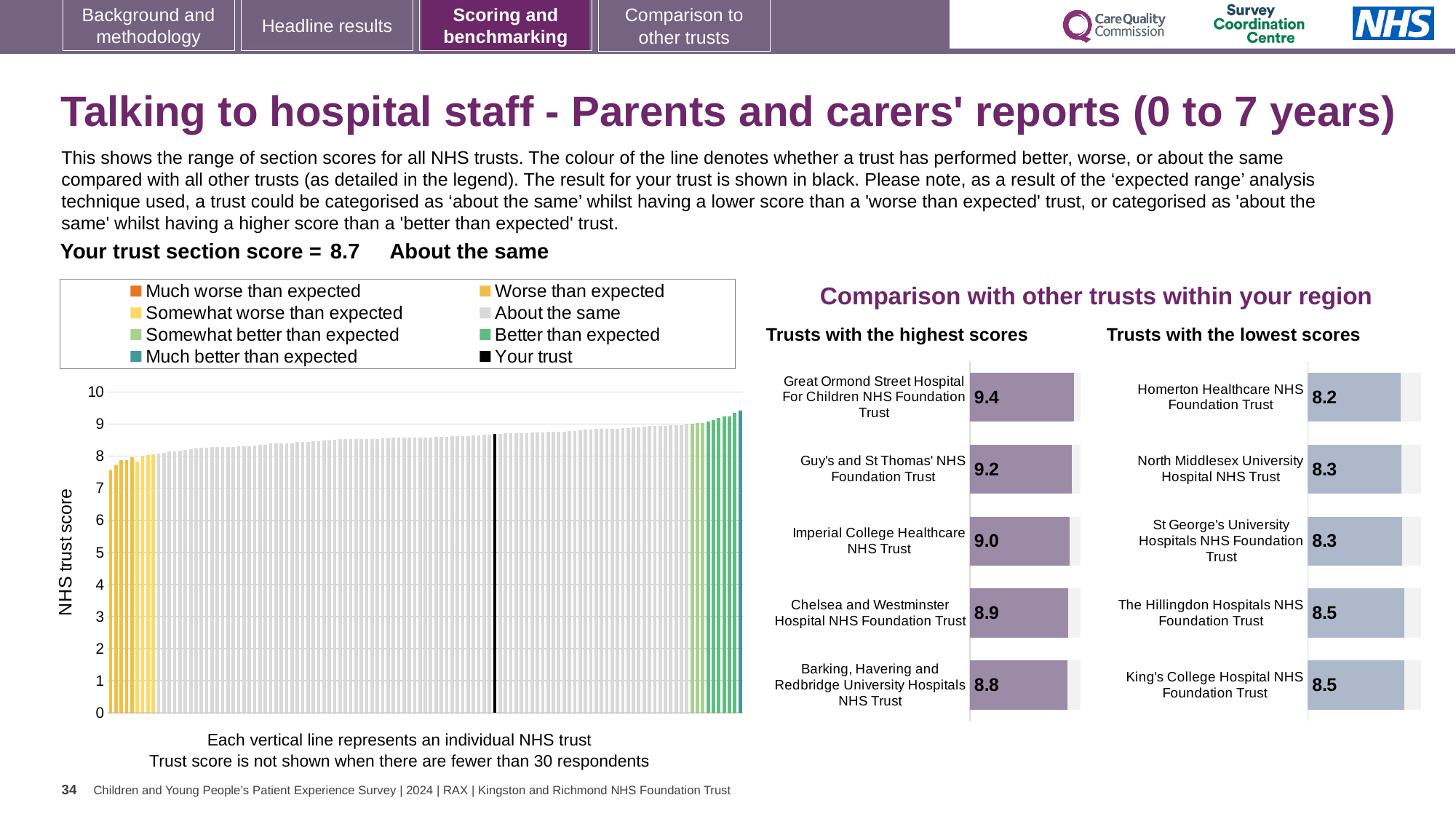
In the 'Trusts with the lowest scores' chart, which has the higher score: Homerton Healthcare NHS Foundation Trust or The Hillingdon Hospitals NHS Foundation Trust? The Hillingdon Hospitals NHS Foundation Trust In the 'Trusts with the highest scores' chart, what is the score for Imperial College Healthcare NHS Trust? 9.0 In the 'Trusts with the lowest scores' chart, what is the score for Homerton Healthcare NHS Foundation Trust? 8.2 In the 'Trusts with the lowest scores' chart, how many trusts are shown? 5 In the 'Trusts with the highest scores' chart, which trust has the lowest score? Barking, Havering and Redbridge University Hospitals NHS Trust In the 'Trusts with the lowest scores' chart, what is the difference between the scores of King's College Hospital NHS Foundation Trust and North Middlesex University Hospital NHS Trust? 0.2 In the 'Trusts with the lowest scores' chart, which trust has the lowest score? Homerton Healthcare NHS Foundation Trust In the large chart on the left showing all NHS trusts, what kind of chart is it? Bar chart In the large chart on the left showing all NHS trusts, how many entries does the legend list? 8 In the 'Trusts with the highest scores' chart, what is the difference between the scores of Great Ormond Street Hospital For Children NHS Foundation Trust and Barking, Havering and Redbridge University Hospitals NHS Trust? 0.6 In the 'Trusts with the highest scores' chart, what is the score for Great Ormond Street Hospital For Children NHS Foundation Trust? 9.4 In the large chart on the left showing all NHS trusts, do the trust scores rise or fall from left to right? Rise